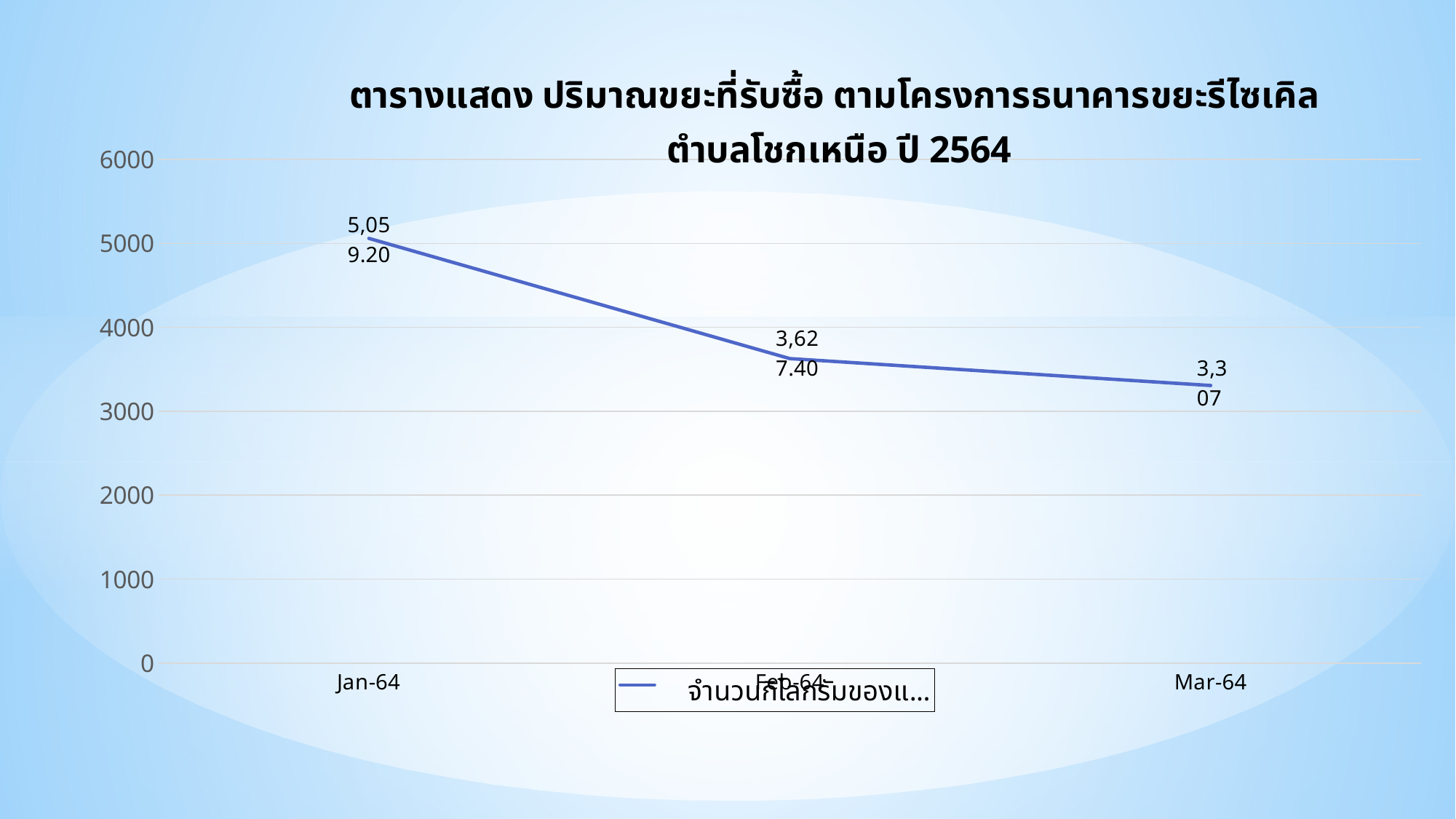
What kind of chart is shown on the slide? line chart How many data points are plotted on the line? 3 Do the values rise or fall from Jan-64 to Mar-64? fall Is the value for Feb-64 greater or less than 4000? less What is the data label shown for Jan-64? 5,059.20 What year is stated in the chart title? 2564 How many series does the legend list? 1 Is the value for Jan-64 greater or less than 5000? greater Which is larger, the value for Feb-64 or the value for Mar-64? Feb-64 Which month has the lowest value? Mar-64 Is the value for Mar-64 greater or less than 3000? greater Which month has the highest value? Jan-64